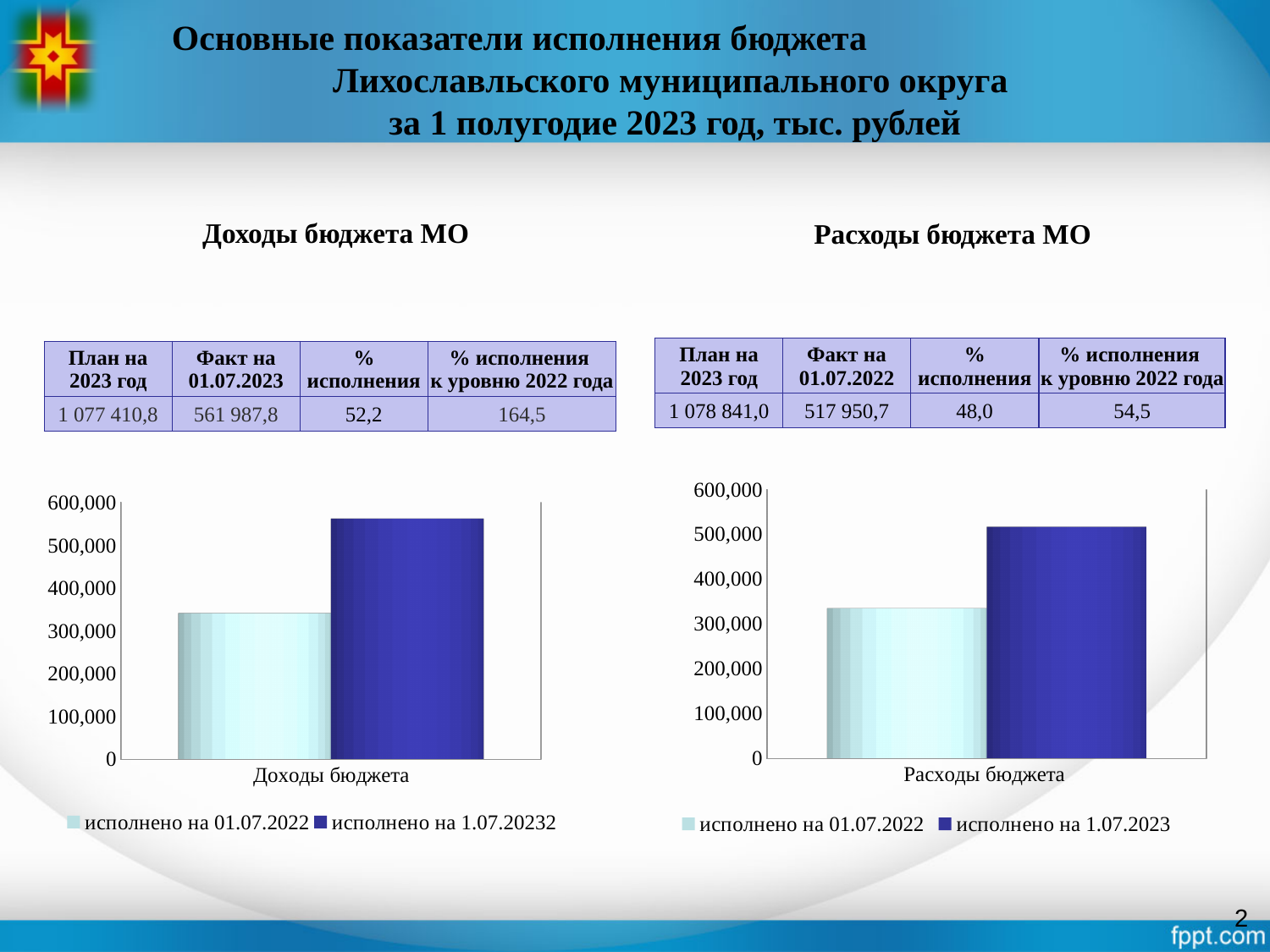
In the right chart (Расходы бюджета), which series has the taller bar: исполнено на 01.07.2022 or исполнено на 1.07.2023? исполнено на 1.07.2023 In the left chart (Доходы бюджета), how many series does the legend list? 2 In the right chart (Расходы бюджета), is the value for исполнено на 1.07.2023 greater or less than 400,000? greater In the left chart (Доходы бюджета), which series has the taller bar: исполнено на 01.07.2022 or исполнено на 1.07.2023? исполнено на 1.07.2023 In the left chart (Доходы бюджета), is the value for исполнено на 01.07.2022 greater or less than 400,000? less What kind of chart is the right chart (Расходы бюджета)? bar chart In the right chart (Расходы бюджета), how many categories are shown on the x axis? 1 What kind of chart is the left chart (Доходы бюджета)? bar chart In the right chart (Расходы бюджета), is the value for исполнено на 01.07.2022 greater or less than 300,000? greater What is the category label on the x axis of the right chart? Расходы бюджета In the left chart (Доходы бюджета), what is the first legend entry? исполнено на 01.07.2022